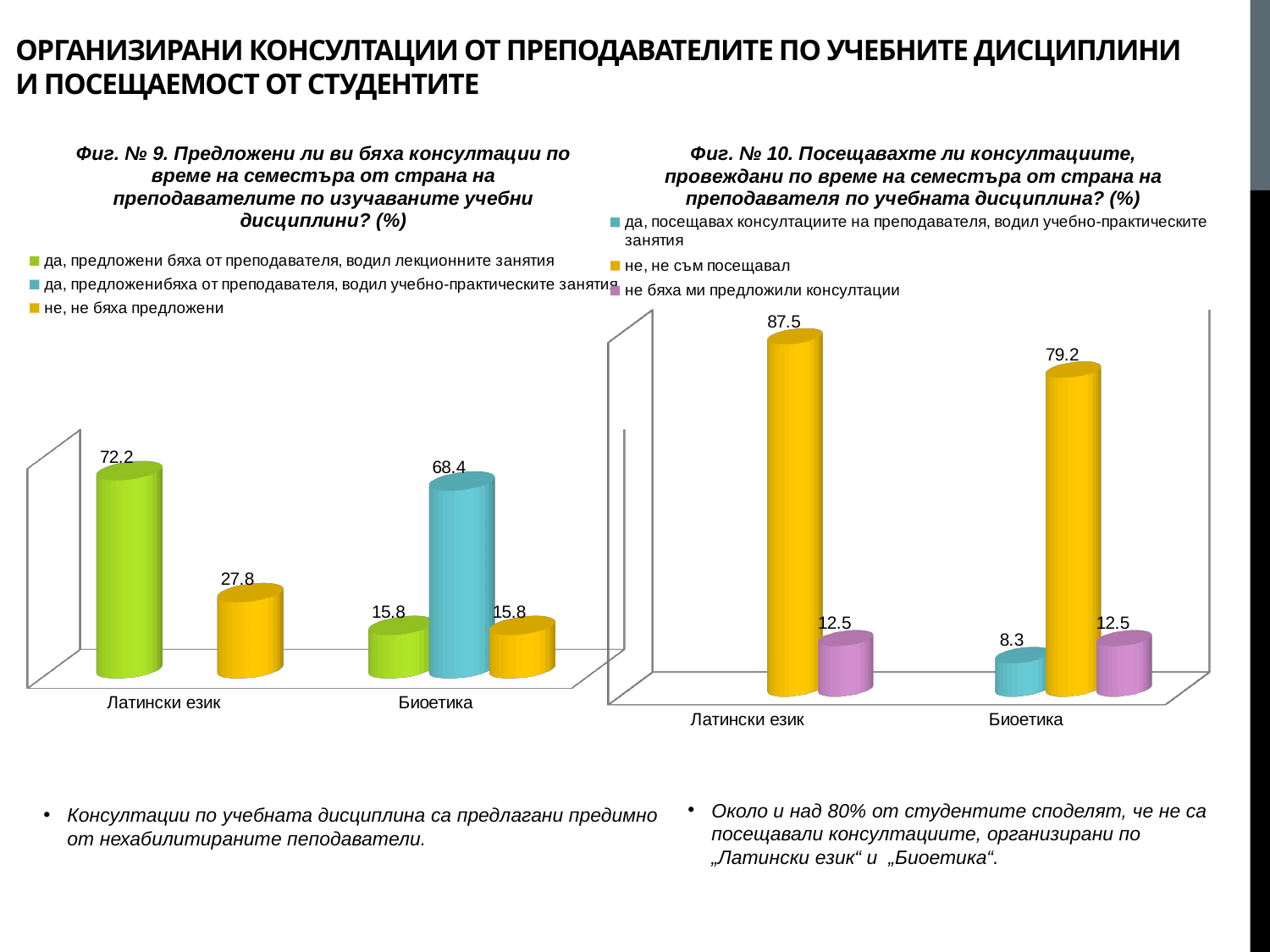
In the right chart (Фиг. № 10), what is the difference between the 'не, не съм посещавал' values for Латински език and Биоетика? 8.3 What type of chart is the right chart (Фиг. № 10)? Bar chart In the left chart (Фиг. № 9), how many series does the legend list? 3 In the right chart (Фиг. № 10), what is the value for 'да, посещавах консултациите на преподавателя, водил учебно-практическите занятия' for Биоетика? 8.3 In the right chart (Фиг. № 10), which is larger: the 'не, не съм посещавал' value for Латински език or for Биоетика? Латински език In the left chart (Фиг. № 9), what is the value for 'не, не бяха предложени' for Латински език? 27.8 In the right chart (Фиг. № 10), what is the value for 'не, не съм посещавал' for Биоетика? 79.2 In the left chart (Фиг. № 9), which series has the highest value for Биоетика? да, предложени бяха от преподавателя, водил учебно-практическите занятия In the right chart (Фиг. № 10), what is the value for 'не, не съм посещавал' for Латински език? 87.5 In the left chart (Фиг. № 9), what is the value for 'да, предложени бяха от преподавателя, водил учебно-практическите занятия' for Биоетика? 68.4 In the left chart (Фиг. № 9), what is the value for 'да, предложени бяха от преподавателя, водил лекционните занятия' for Латински език? 72.2 In the left chart (Фиг. № 9), what is the difference between the 'лекционните занятия' value for Латински език and the 'не, не бяха предложени' value for Латински език? 44.4